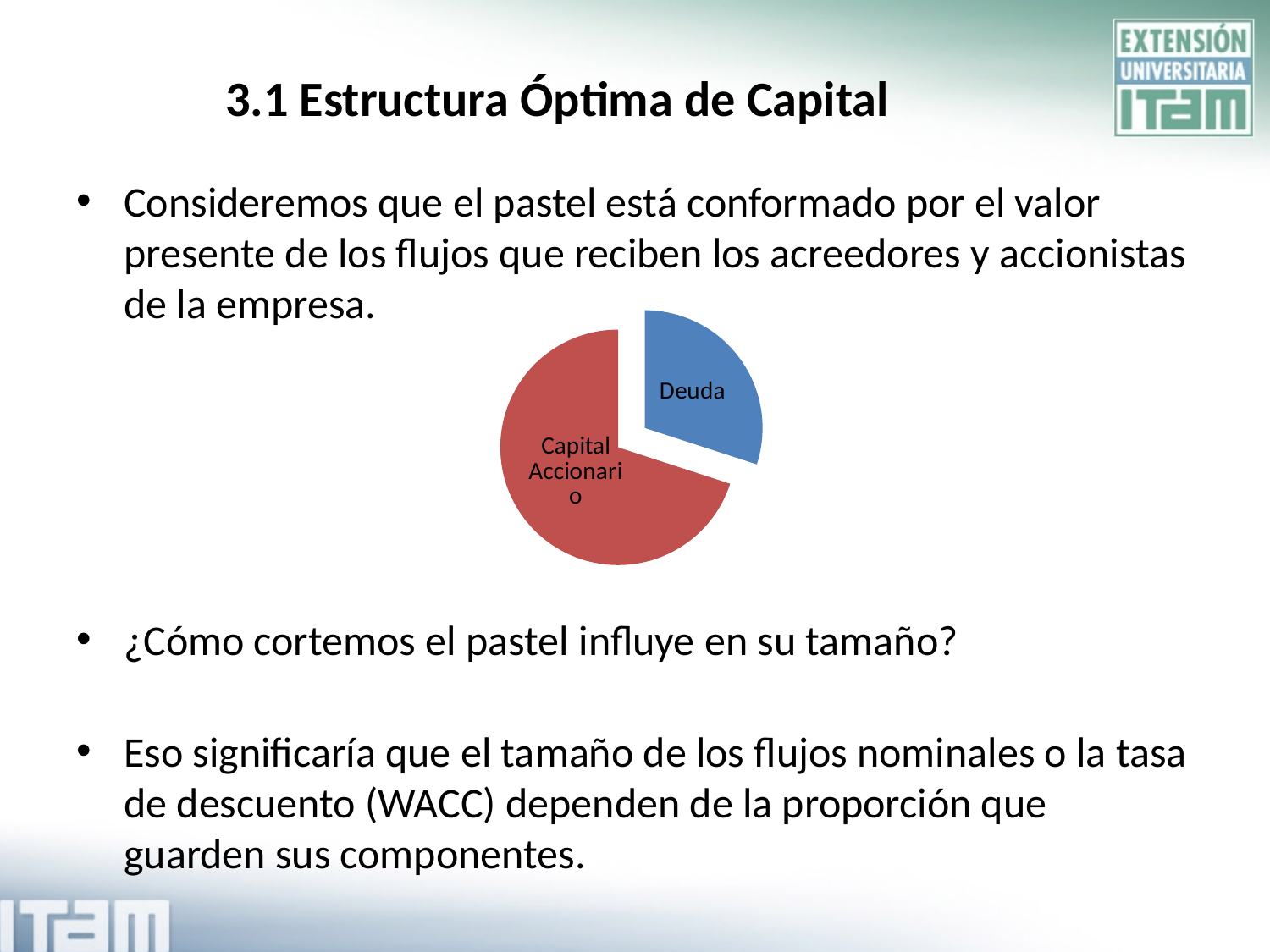
What colour is the Deuda slice in the pie chart? Blue Which slice of the pie chart is the smallest? Deuda What kind of chart is shown on the slide? Pie chart Which slice of the pie chart is the largest? Capital Accionario What colour is the Capital Accionario slice in the pie chart? Red How many slices does the pie chart have? 2 What are the labels of the two slices in the pie chart? Deuda and Capital Accionario Which slice is larger in the pie chart, Deuda or Capital Accionario? Capital Accionario